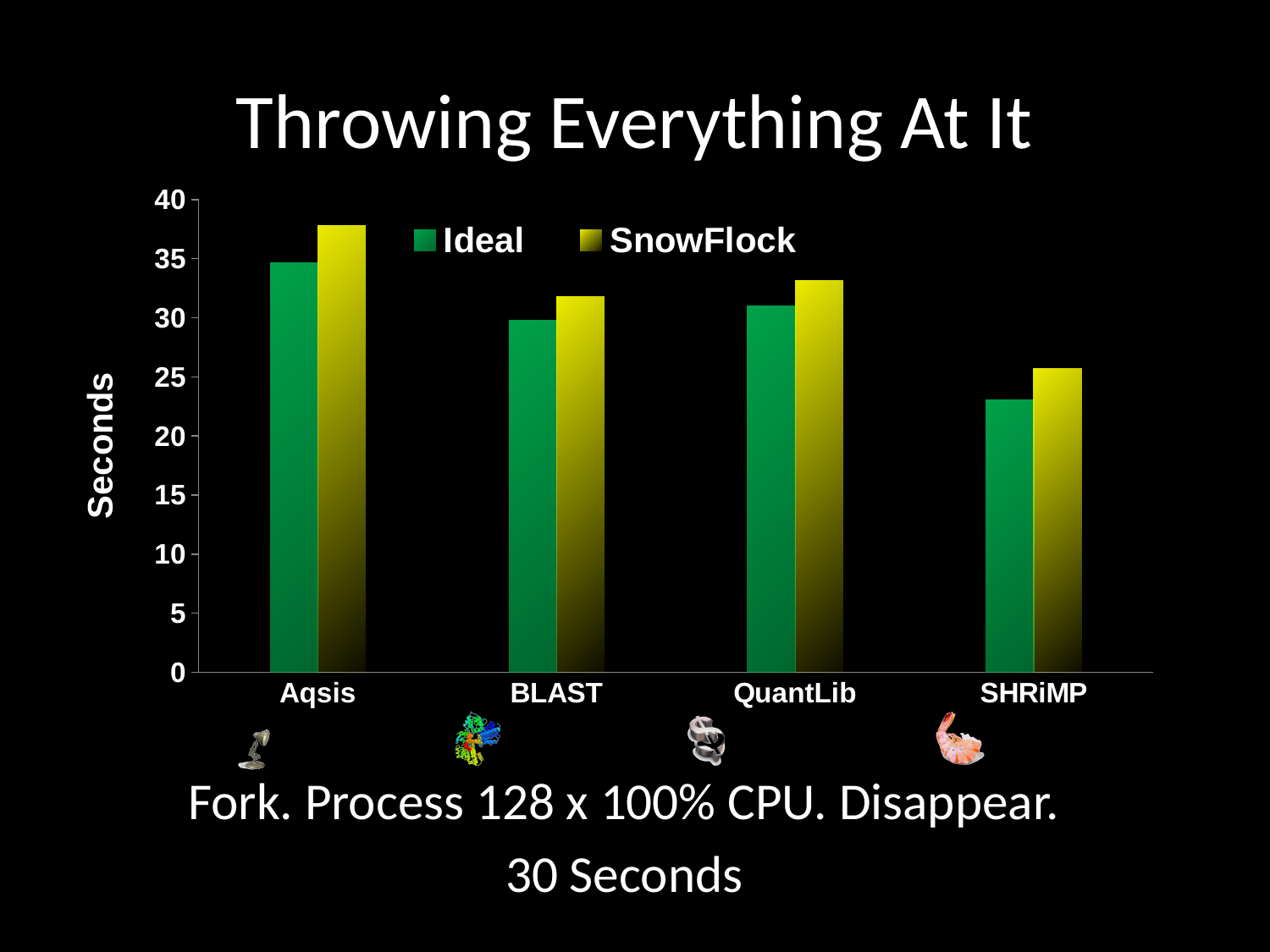
What is the label on the y axis of the chart? Seconds Is the SnowFlock value for Aqsis greater or less than 35? greater How many series does the chart's legend list? 2 What kind of chart is shown on the slide? bar chart Which category has the highest SnowFlock value? Aqsis Which category has the lowest Ideal value? SHRiMP Is the Ideal value for SHRiMP greater or less than 25? less Which category has the lowest SnowFlock value? SHRiMP For Aqsis, which is larger: the Ideal value or the SnowFlock value? SnowFlock Which is larger: the Ideal value for BLAST or the Ideal value for SHRiMP? BLAST How many categories are shown on the x axis of the chart? 4